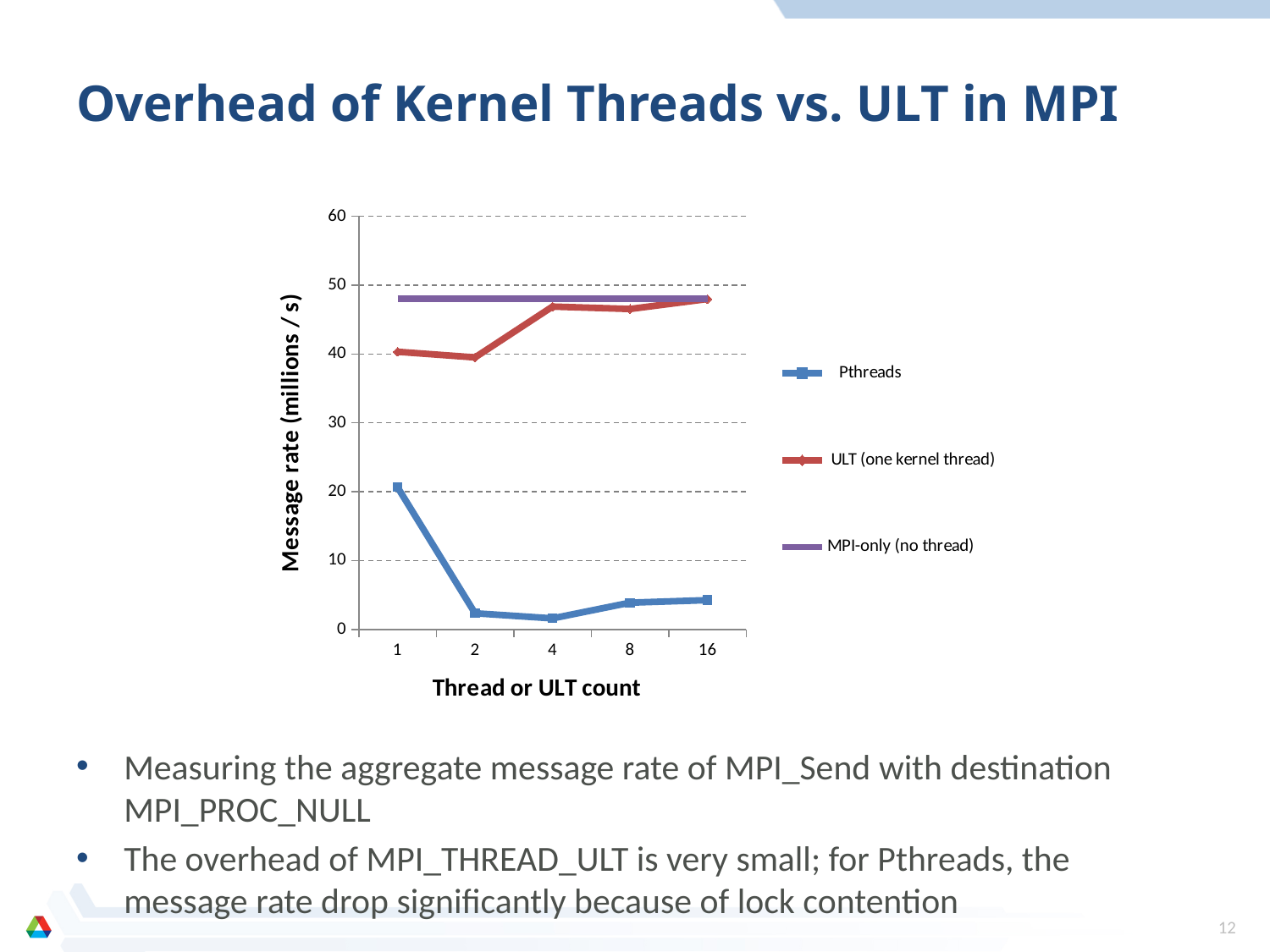
How many series does the legend list? 3 Is the MPI-only (no thread) value greater or less than 50? less Which series has the lowest message rate at thread or ULT count 16? Pthreads Is the Pthreads value at thread count 2 greater or less than 10? less What is the label of the y axis? Message rate (millions / s) At thread or ULT count 4, which is larger: Pthreads or ULT (one kernel thread)? ULT (one kernel thread) Which series is drawn in purple? MPI-only (no thread) Is the ULT (one kernel thread) value at ULT count 4 greater or less than 40? greater How many thread or ULT count values are plotted on the x axis? 5 What kind of chart is shown on the slide? line chart Does the Pthreads message rate rise or fall from thread count 1 to thread count 2? fall